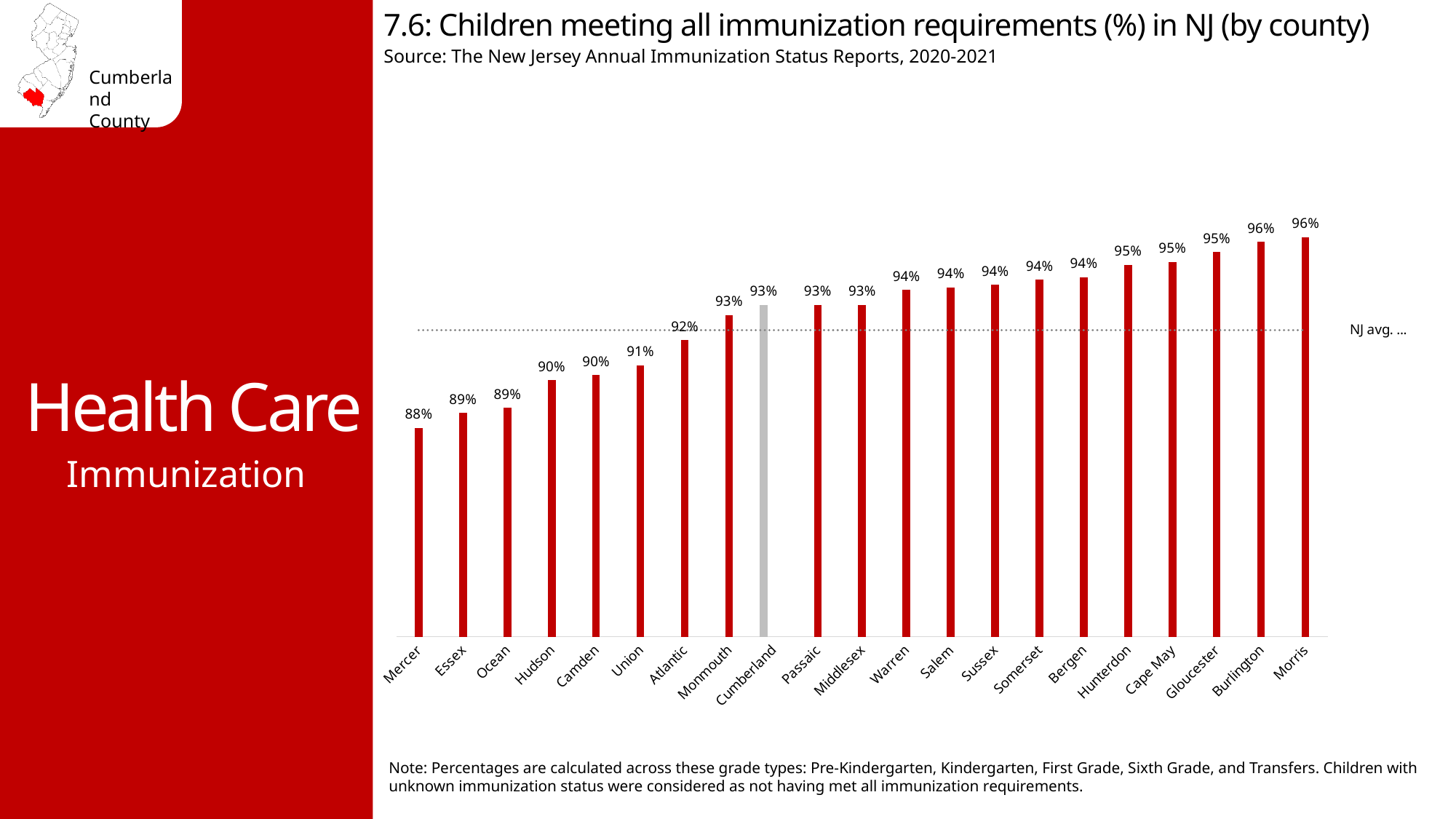
Which has a higher value, Atlantic County or Hunterdon County? Hunterdon What is the value shown for Mercer County? 88% What kind of chart is used on this slide? Bar chart What percentage of children met all immunization requirements in Cumberland County? 93% What is the difference in percentage points between Cumberland County and Mercer County? 5 percentage points What is the value shown for Atlantic County? 92% What is the value shown for Hunterdon County? 95% How many counties are shown on the chart? 21 Which county has the lowest percentage of children meeting all immunization requirements? Mercer Do the values rise or fall moving from left to right across the counties? Rise What is the difference in percentage points between Morris County and Mercer County? 8 percentage points Which has a higher value, Cumberland County or Union County? Cumberland